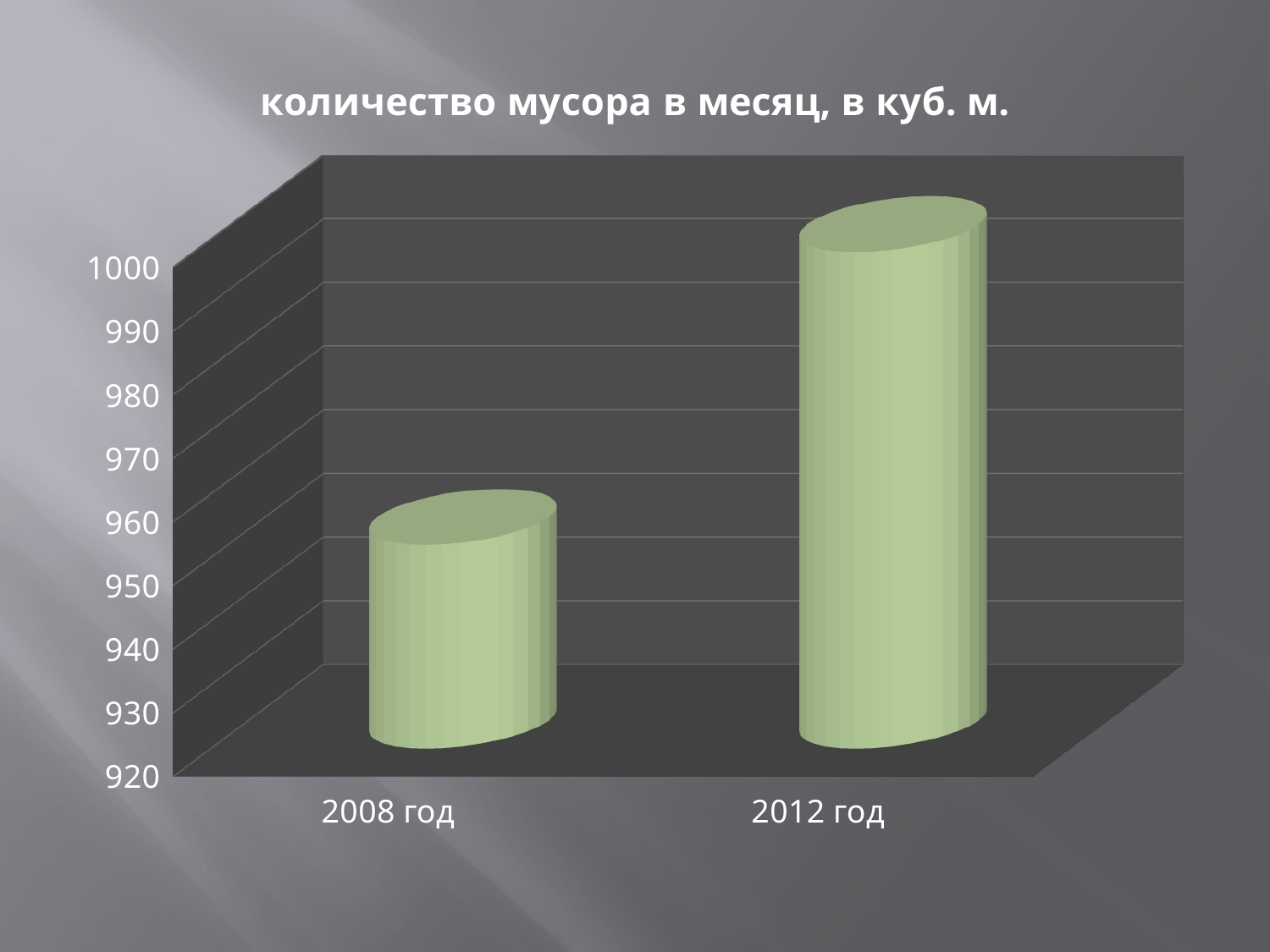
What kind of chart is shown on the slide? bar chart Do the values rise or fall from 2008 год to 2012 год? rise Is the value for 2008 год greater or less than 940? greater What is the title of the chart? количество мусора в месяц, в куб. м. How many categories are shown on the x axis of the chart? 2 Which category has the highest value in the chart? 2012 год Is the value for 2012 год greater or less than 980? greater Is the value for 2008 год greater or less than 980? less Which category has the lowest value in the chart? 2008 год What is the lowest value shown on the vertical axis of the chart? 920 Which is larger, the value for 2008 год or the value for 2012 год? 2012 год